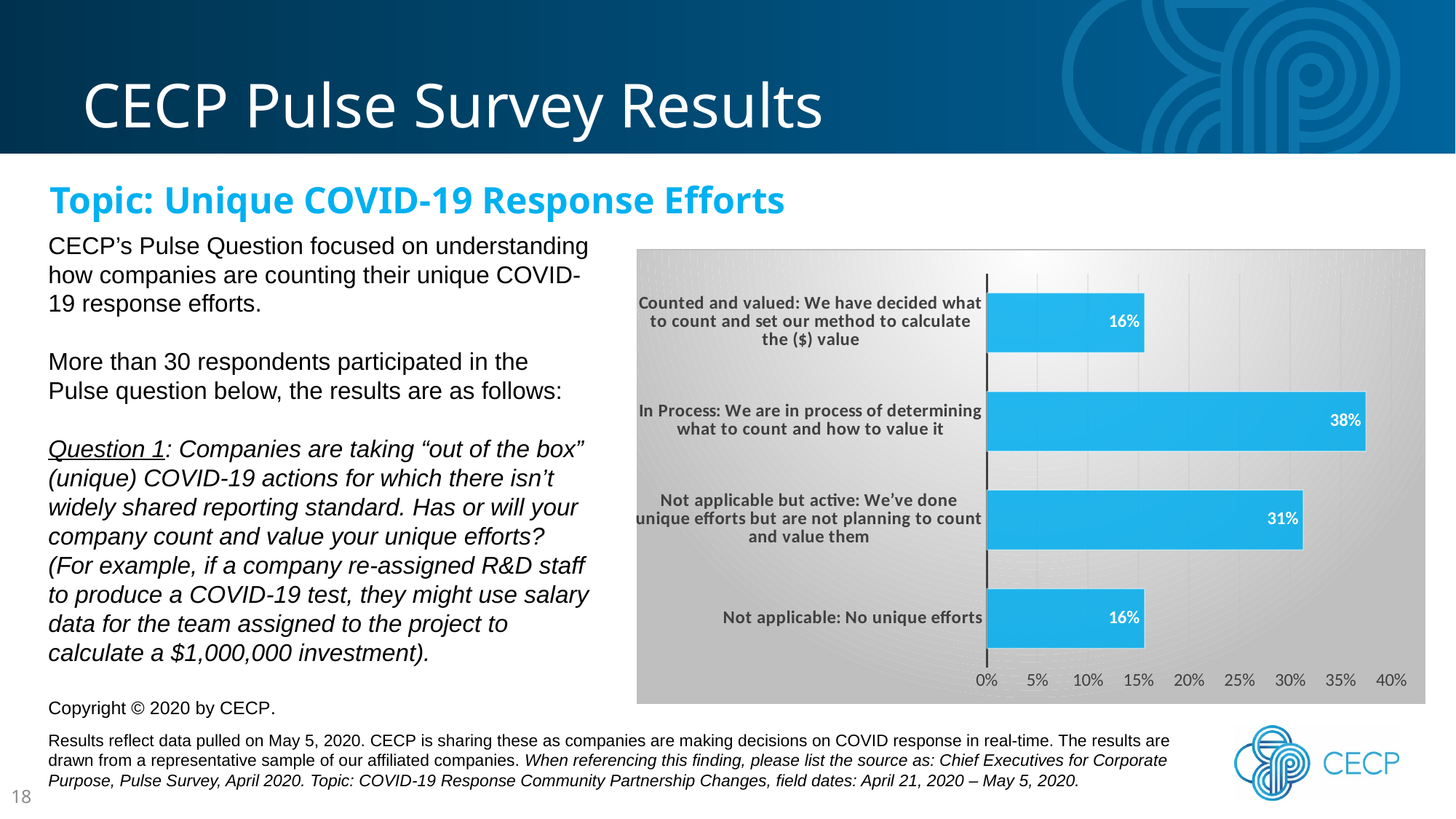
Which is larger: the value for "In Process" or the value for "Counted and valued"? In Process What percentage of respondents answered "Not applicable: No unique efforts"? 16% Which response category has the highest percentage? In Process: We are in process of determining what to count and how to value it What is the difference in percentage points between the "Not applicable but active" category and the "Not applicable: No unique efforts" category? 15% What percentage of respondents answered "Counted and valued: We have decided what to count and set our method to calculate the ($) value"? 16% What percentage of respondents answered "In Process: We are in process of determining what to count and how to value it"? 38% What type of chart is shown on the slide? Bar chart What is the difference in percentage points between the "In Process" category and the "Not applicable but active" category? 7% How many response categories are shown in the chart? 4 What percentage of respondents answered "Not applicable but active: We've done unique efforts but are not planning to count and value them"? 31% Is the value for "Not applicable but active" greater or less than 25%? greater What is the maximum value shown on the chart's horizontal axis? 40%